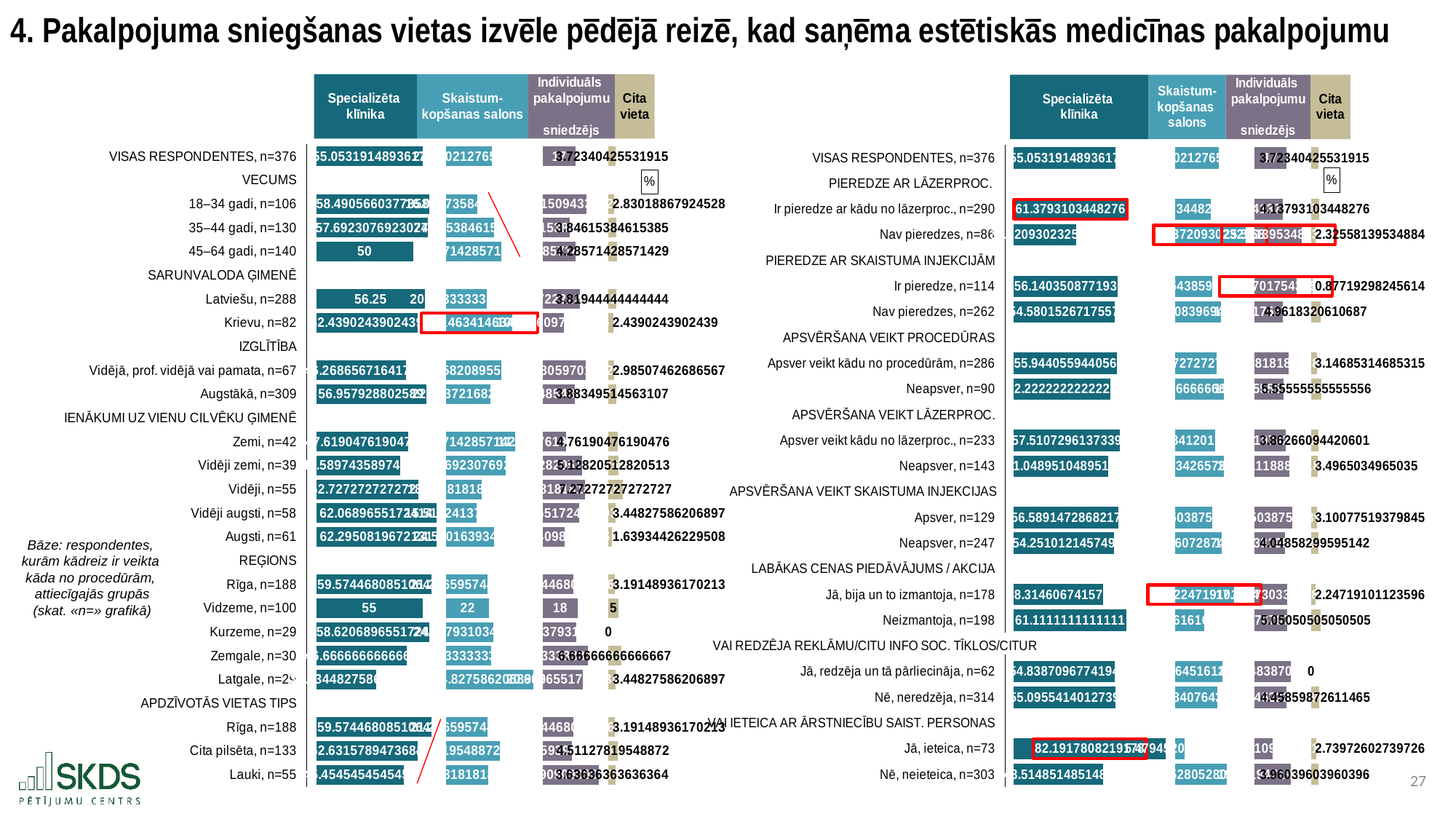
In the left chart, what is the total of the stacked bar for 'Vidzeme, n=100'? 100 In the left chart, what is the value for Specializēta klīnika for '45–64 gadi, n=140'? 50 In the right chart, what is the value for Specializēta klīnika for 'Ir pieredze ar kādu no lāzerproc., n=290'? 61.3793103448276 In the left chart, what is the value for Individuāls pakalpojumu sniedzējs for 'Vidzeme, n=100'? 18 In the right chart, what is the value for Cita vieta for 'Jā, redzēja un tā pārliecināja, n=62'? 0 In the left chart, what is the value for Specializēta klīnika for 'Latviešu, n=288'? 56.25 In the left chart, what is the value for Skaistumkopšanas salons for 'Vidzeme, n=100'? 22 In the right chart, which category has the highest value for Specializēta klīnika? Jā, ieteica, n=73 In the left chart, what is the value for Specializēta klīnika for the category 'Vidzeme, n=100'? 55 In the left chart, what is the value for Cita vieta for 'Kurzeme, n=29'? 0 How many series does the legend of the left chart list? 4 What kind of chart is shown on the left side of the slide? Stacked bar chart